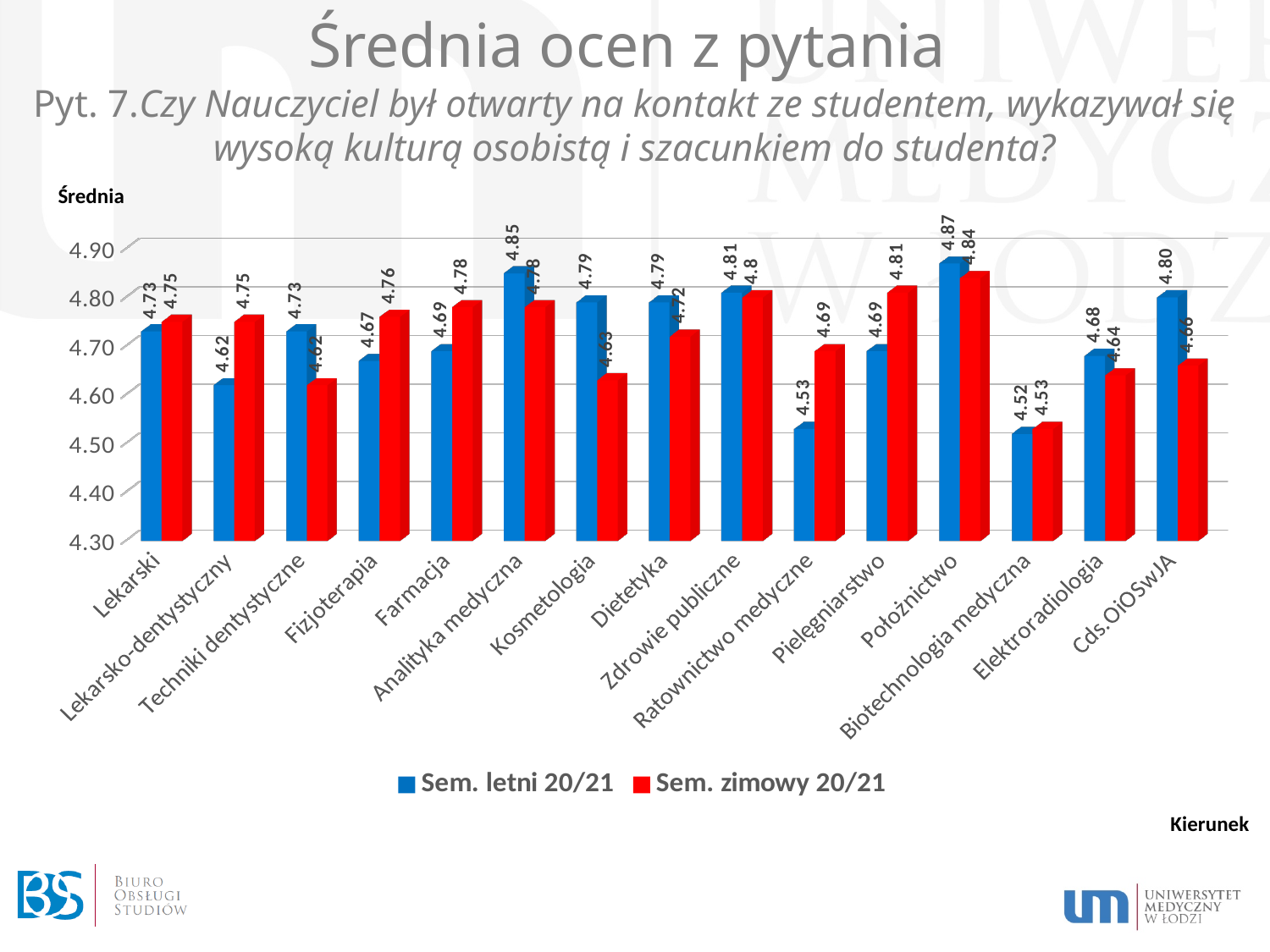
Which colour represents Sem. zimowy 20/21 in the legend? red What is the difference between the Sem. zimowy 20/21 and Sem. letni 20/21 values for Lekarsko-dentystyczny? 0.13 Which is larger for Fizjoterapia: the Sem. letni 20/21 value or the Sem. zimowy 20/21 value? Sem. zimowy 20/21 Which kierunek has the lowest value in Sem. letni 20/21? Biotechnologia medyczna What is the value for Lekarski in Sem. letni 20/21? 4.73 How many kierunki (categories) are shown on the x axis? 15 Which kierunek has the highest value in Sem. letni 20/21? Położnictwo What is the value for Pielęgniarstwo in Sem. zimowy 20/21? 4.81 What kind of chart is shown on the slide? bar chart Is the value for Biotechnologia medyczna in Sem. zimowy 20/21 greater or less than 4.60? less What is the value for Ratownictwo medyczne in Sem. letni 20/21? 4.53 How many series does the legend list? 2